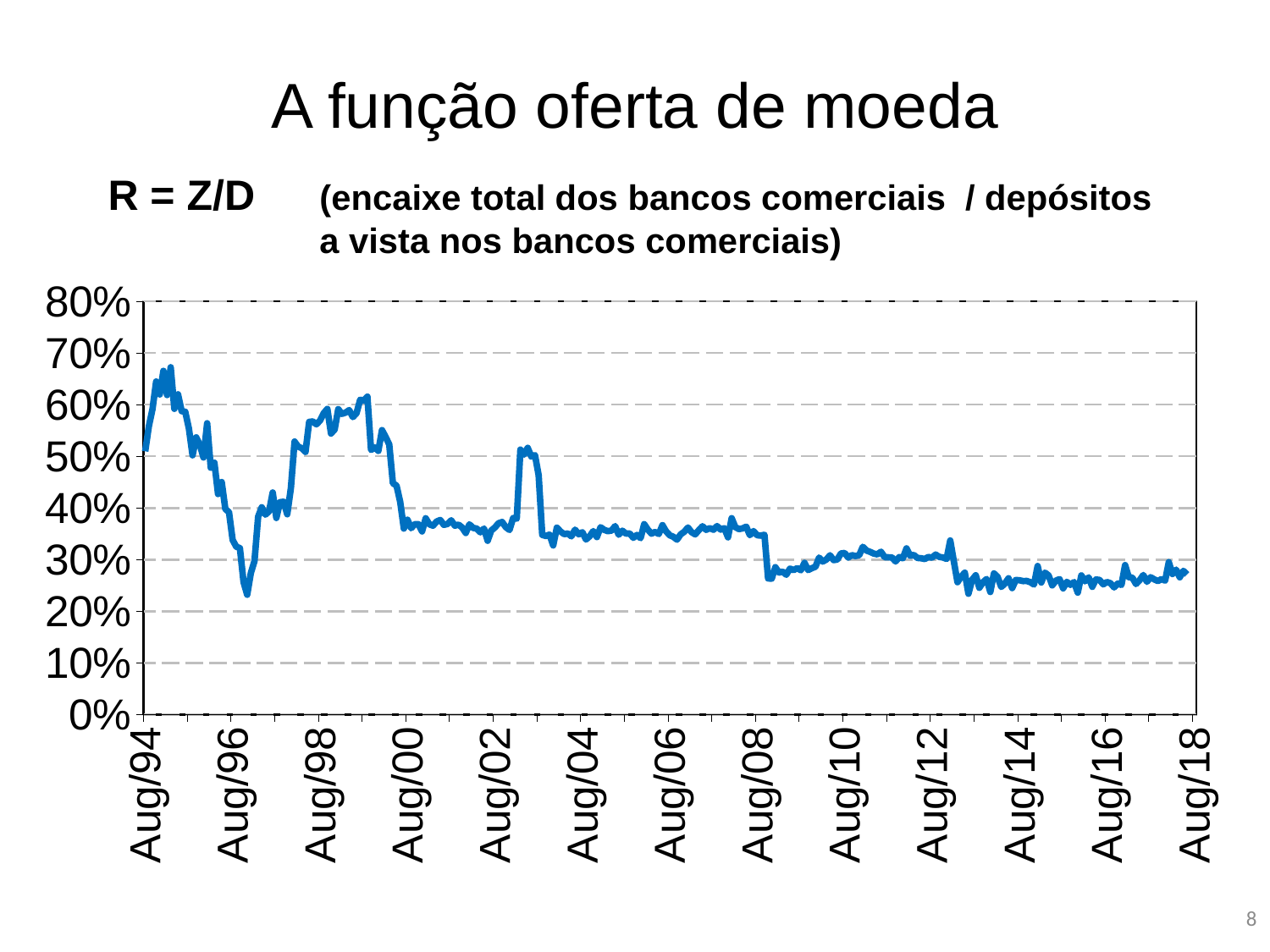
Is the value at Aug/18 greater or less than 40%? less Overall, does the line rise or fall from Aug/94 to Aug/18? fall Is the value at Aug/00 greater or less than 50%? less Is the value at Aug/16 greater or less than 40%? less How many date labels are shown on the x axis? 13 What kind of chart is shown on the slide? line chart Which is larger, the value at Aug/94 or the value at Aug/18? Aug/94 What is the highest value shown on the y axis? 80% Which is larger, the value at Aug/98 or the value at Aug/02? Aug/98